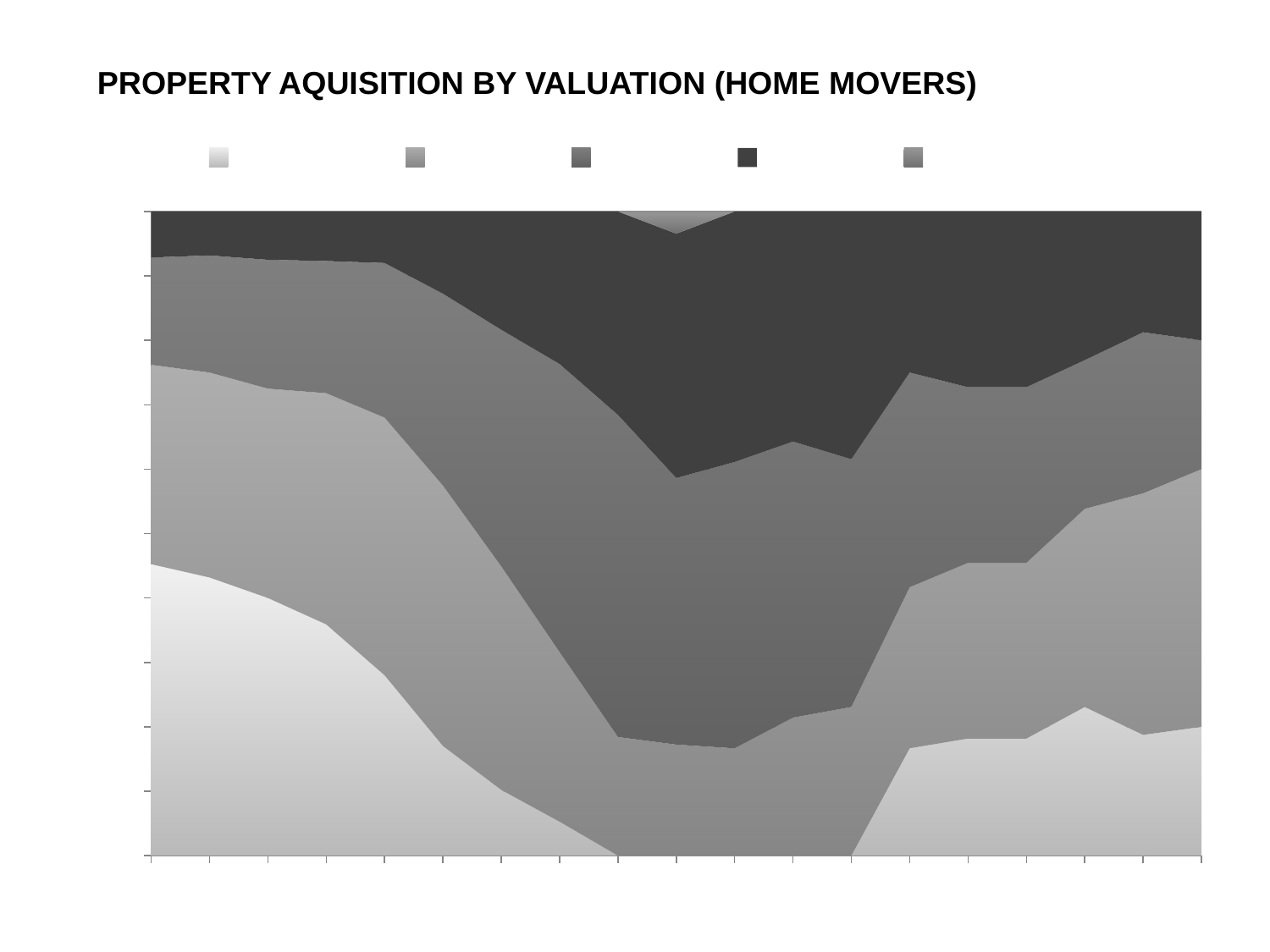
Does the darkest (top) area get thicker or thinner from the left edge of the chart toward the middle? Thicker What is the title of the chart? PROPERTY AQUISITION BY VALUATION (HOME MOVERS) What kind of chart is shown on the slide? Area chart Are the legend entries labelled with readable text? No Does the lightest (bottom) area rise or fall from the left edge of the chart toward the middle? Fall How many series does the legend list? 5